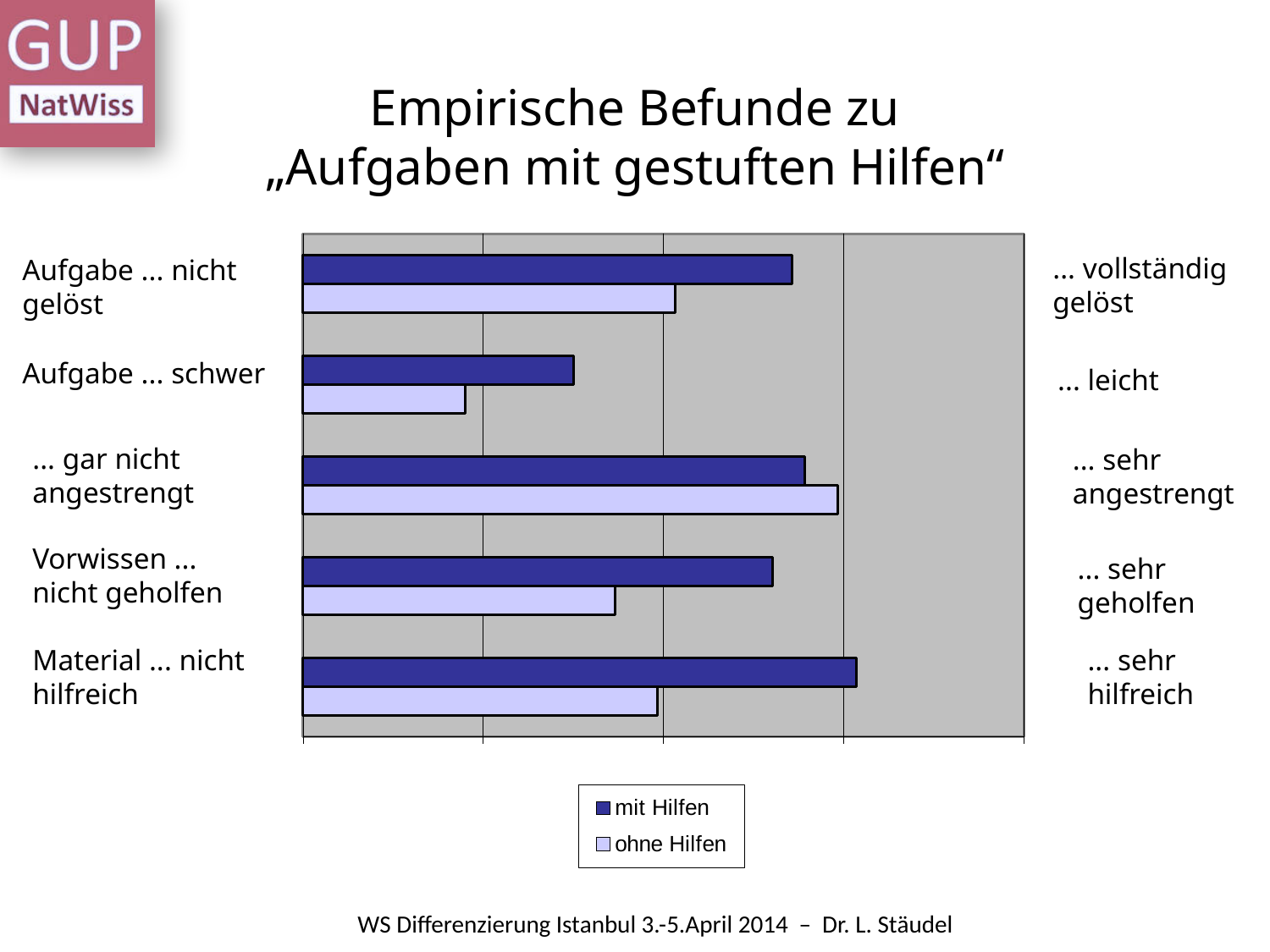
Which item has the shortest bar for the series mit Hilfen? Aufgabe … schwer / … leicht What kind of chart is shown on the slide? bar chart For the item 'Aufgabe … schwer / … leicht', which series has the longer bar, mit Hilfen or ohne Hilfen? mit Hilfen For the item 'Material … nicht hilfreich / … sehr hilfreich', which series has the longer bar, mit Hilfen or ohne Hilfen? mit Hilfen For the item 'Vorwissen … nicht geholfen / … sehr geholfen', which series has the longer bar, mit Hilfen or ohne Hilfen? mit Hilfen What are the two series named in the legend? mit Hilfen, ohne Hilfen How many series does the legend list? 2 Which item has the longest bar for the series mit Hilfen? Material … nicht hilfreich / … sehr hilfreich Which item has the longest bar for the series ohne Hilfen? … gar nicht angestrengt / … sehr angestrengt How many item pairs (categories) are plotted in the chart? 5 Which series is drawn in dark blue? mit Hilfen